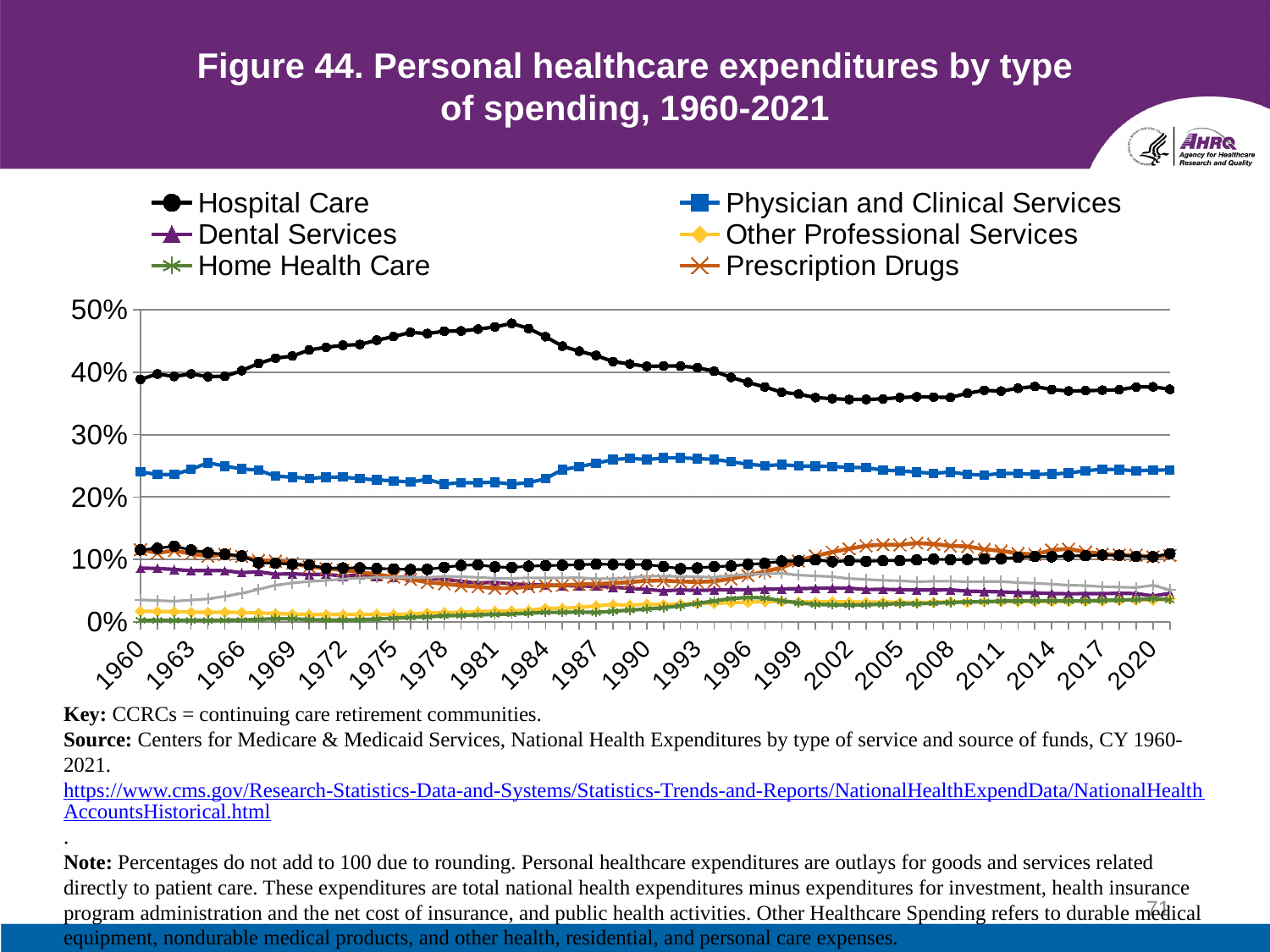
Is the value for Physician and Clinical Services in 2020 greater or less than 20%? greater In 1960, which is larger: Hospital Care or Physician and Clinical Services? Hospital Care Is the value for Home Health Care in 1960 greater or less than 10%? less Which series has the highest values across the whole period? Hospital Care Is the value for Dental Services in 2020 greater or less than 10%? less What is the title of the chart? Figure 44. Personal healthcare expenditures by type of spending, 1960-2021 How many series does the legend list? 6 Does the Hospital Care line rise or fall between 1983 and 2005? fall What kind of chart is shown on the slide? line chart